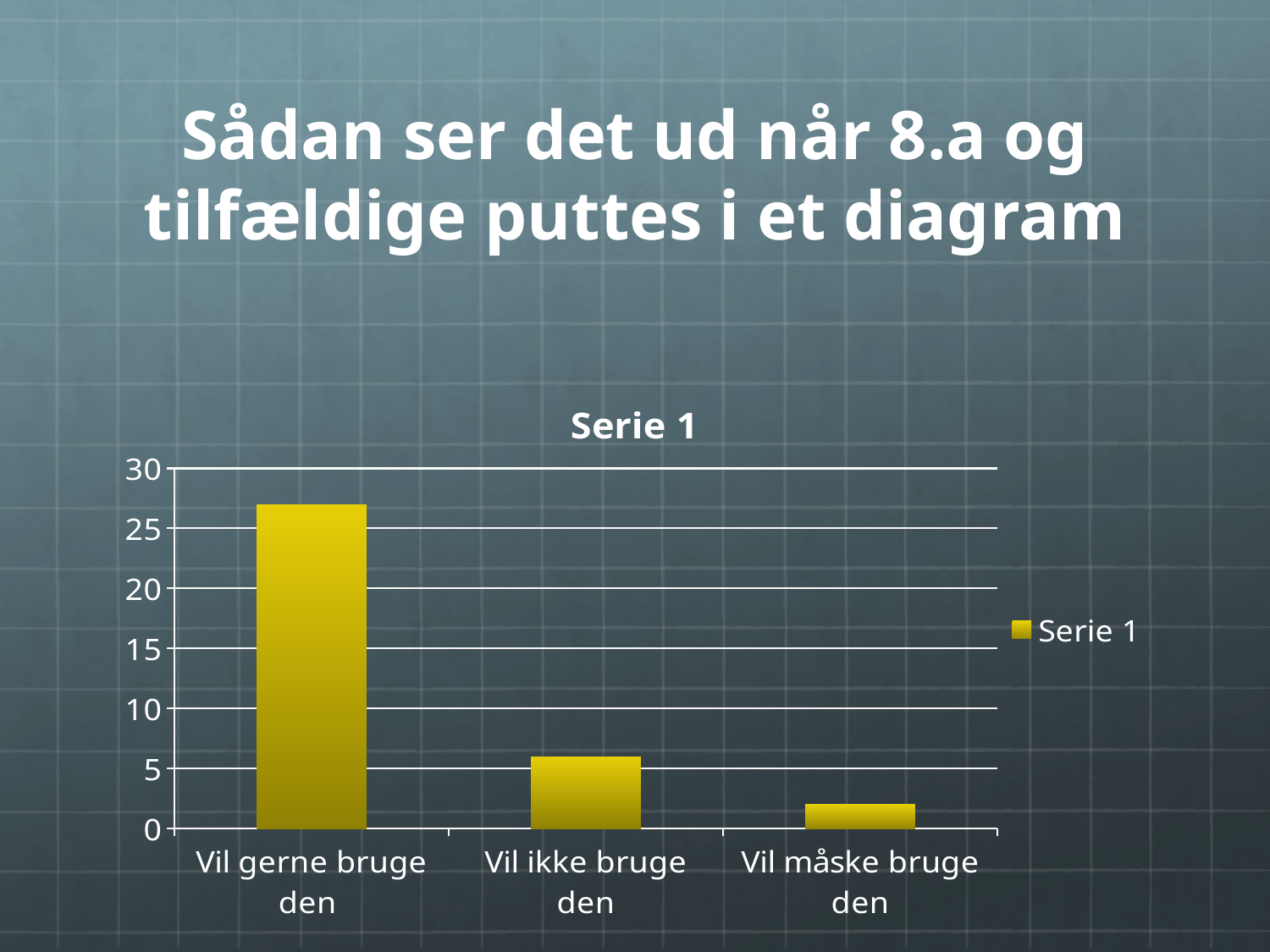
Is the value for Vil gerne bruge den greater or less than 25? greater Which category has the highest value in the chart? Vil gerne bruge den Is the value for Vil ikke bruge den greater or less than 5? greater Is the value for Vil ikke bruge den greater or less than 10? less What is the title of the chart? Serie 1 Which is larger, the value for Vil ikke bruge den or the value for Vil måske bruge den? Vil ikke bruge den How many categories are shown on the x axis of the chart? 3 Do the values rise or fall from left to right along the x axis? fall How many series does the chart's legend list? 1 What kind of chart is shown on the slide? bar chart Which category has the lowest value in the chart? Vil måske bruge den